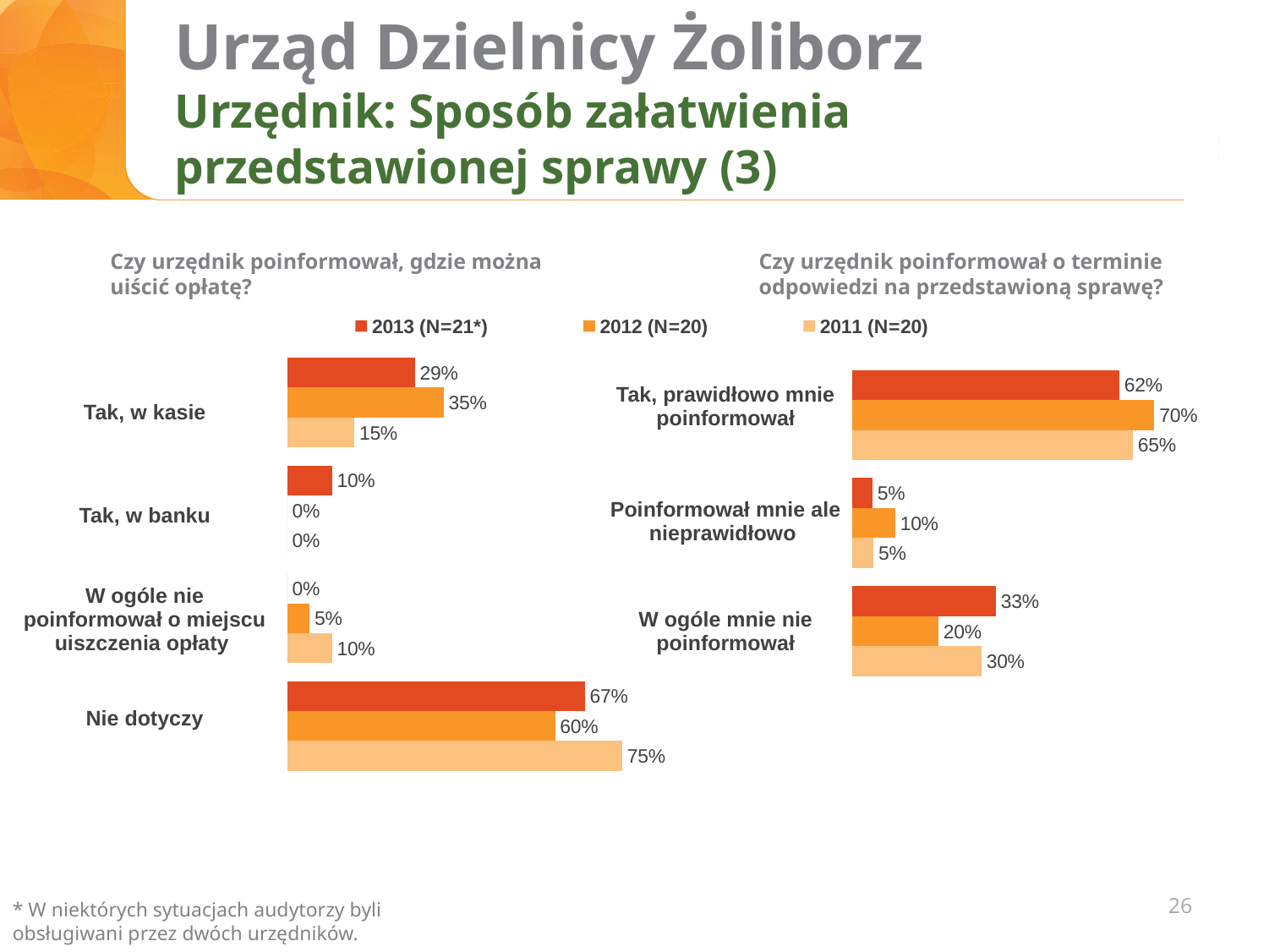
How many series does the legend list? 3 How many categories does the left chart (Czy urzędnik poinformował, gdzie można uiścić opłatę?) show? 4 In the right chart (Czy urzędnik poinformował o terminie odpowiedzi na przedstawioną sprawę?), what is the value for 'W ogóle mnie nie poinformował' in 2013? 33% In the left chart (Czy urzędnik poinformował, gdzie można uiścić opłatę?), which category has the highest value for 2013? Nie dotyczy In the left chart (Czy urzędnik poinformował, gdzie można uiścić opłatę?), what is the difference between the 2012 and 2011 values for 'Tak, w kasie'? 20 percentage points In the right chart (Czy urzędnik poinformował o terminie odpowiedzi na przedstawioną sprawę?), which category has the lowest value for 2012? Poinformował mnie ale nieprawidłowo What type of chart is the right chart (Czy urzędnik poinformował o terminie odpowiedzi na przedstawioną sprawę?)? Bar chart In the left chart (Czy urzędnik poinformował, gdzie można uiścić opłatę?), what is the value for 'Nie dotyczy' in 2011? 75% In the right chart (Czy urzędnik poinformował o terminie odpowiedzi na przedstawioną sprawę?), what is the value for 'Tak, prawidłowo mnie poinformował' in 2012? 70% In the right chart (Czy urzędnik poinformował o terminie odpowiedzi na przedstawioną sprawę?), which is larger for 'Tak, prawidłowo mnie poinformował': the 2013 value or the 2011 value? 2011 In the left chart (Czy urzędnik poinformował, gdzie można uiścić opłatę?), what is the value for 'Tak, w kasie' in 2013? 29% In the right chart (Czy urzędnik poinformował o terminie odpowiedzi na przedstawioną sprawę?), what is the difference between the 2013 and 2012 values for 'W ogóle mnie nie poinformował'? 13 percentage points